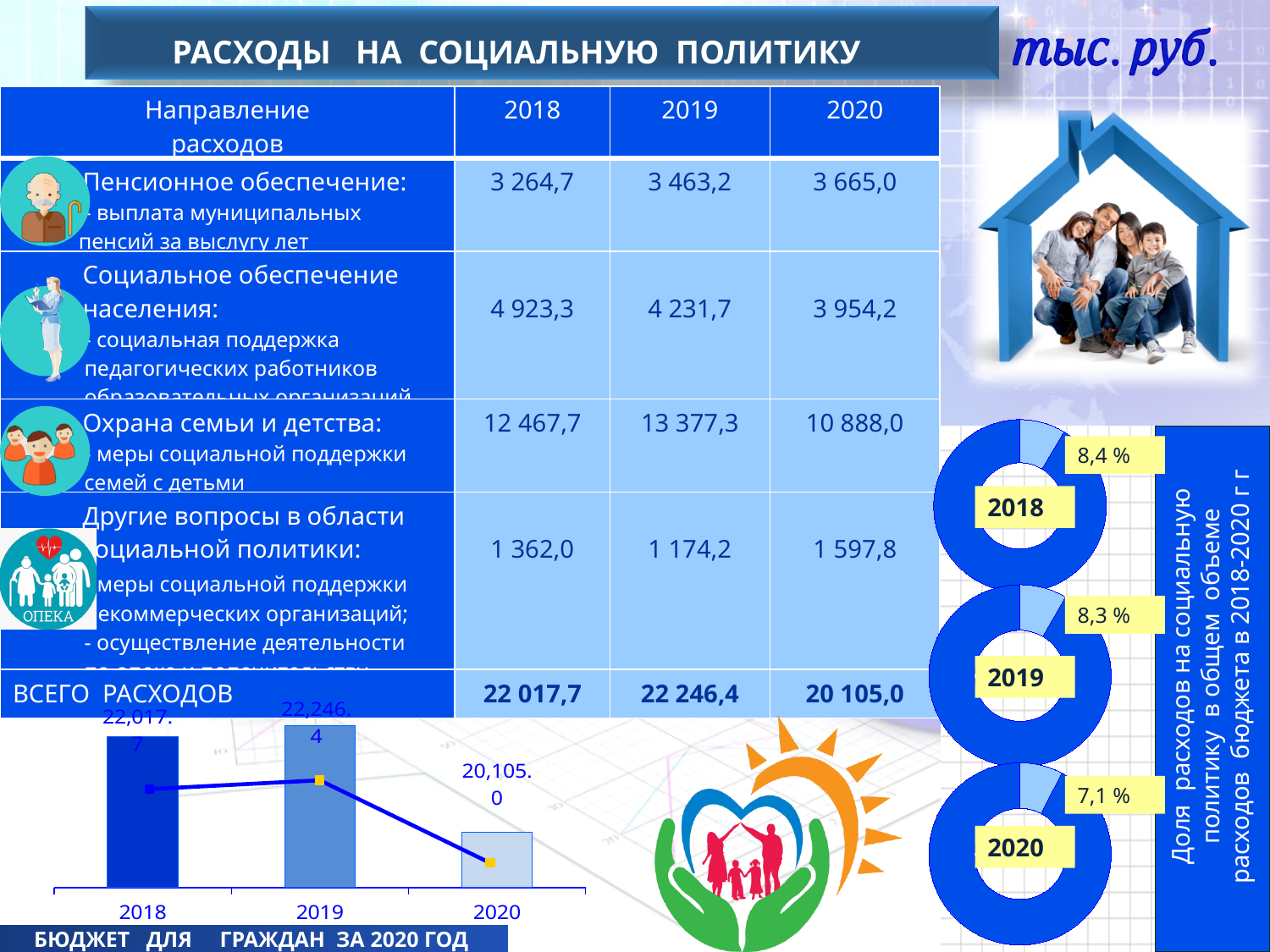
In the bar chart at the bottom left, what is the difference between the values for 2019 and 2020? 2,141.4 In the bar chart at the bottom left, which year has the lowest value? 2020 In the bar chart at the bottom left, which year has the highest value? 2019 Among the donut charts on the right, which year has the smallest share? 2020 In the bar chart at the bottom left, what is the value shown for 2020? 20,105.0 In the bar chart at the bottom left, does the value rise or fall from 2019 to 2020? fall In the donut charts on the right, what share is shown for 2020? 7,1 % In the donut charts on the right, what share is shown for 2018? 8,4 % In the bar chart at the bottom left, what is the value shown for 2019? 22,246.4 How many donut charts are shown on the right side of the slide? 3 In the bar chart at the bottom left, is the value for 2019 larger or smaller than the value for 2020? larger In the bar chart at the bottom left, how many years are shown on the x axis? 3